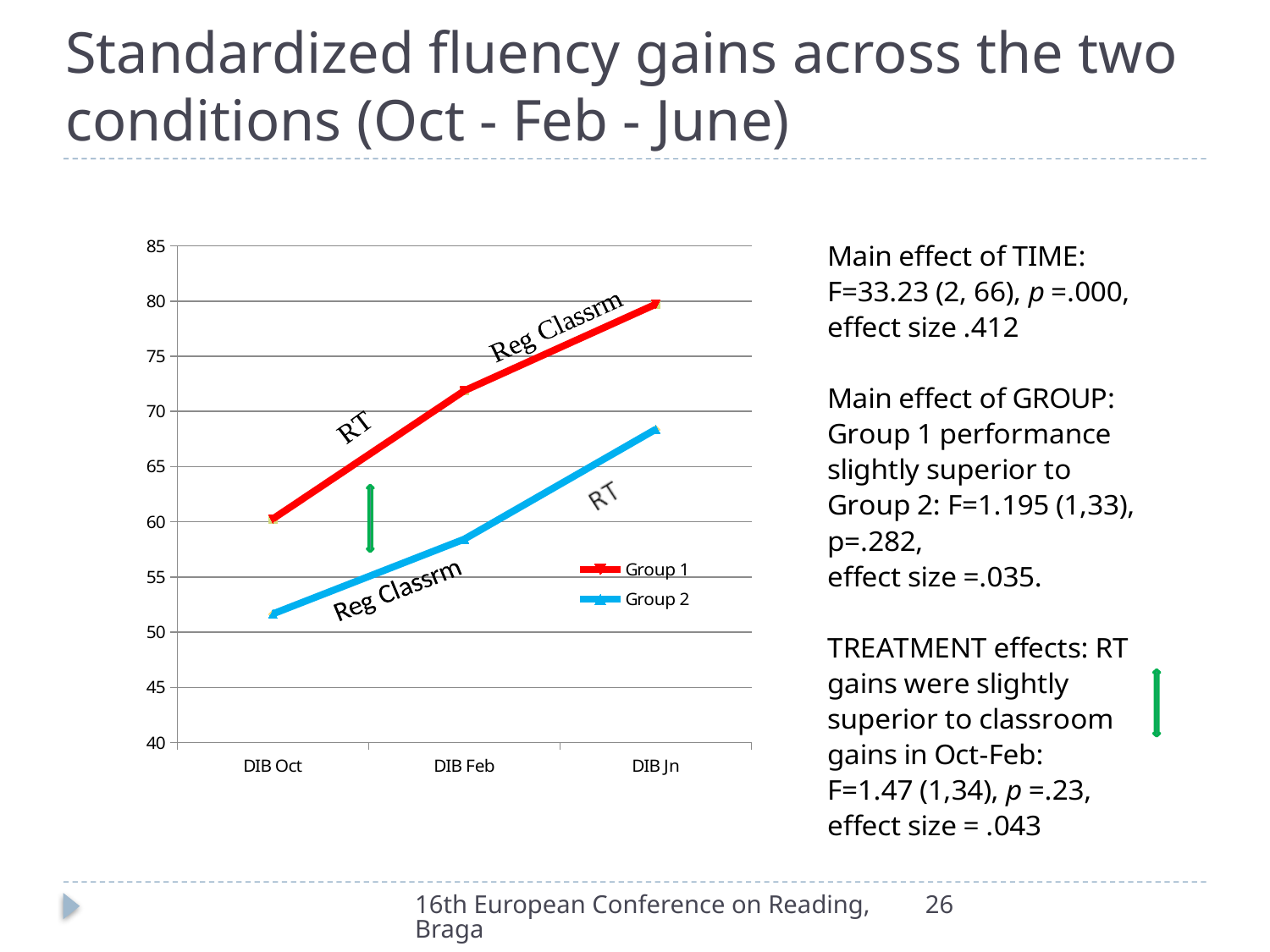
Is the value for Group 2 at DIB Oct greater or less than 55? less Do the values for Group 2 rise or fall from DIB Oct to DIB Jn? rise What kind of chart is shown on the slide? line chart What colour is the line for Group 1 in the chart? red At which time point is the value for Group 2 lowest? DIB Oct Do the values for Group 1 rise or fall from DIB Oct to DIB Jn? rise Is the value for Group 1 at DIB Jn greater or less than 75? greater Is the value for Group 1 at DIB Oct greater or less than 65? less Which series has the larger value at DIB Jn, Group 1 or Group 2? Group 1 How many time points are plotted along the x axis? 3 How many series does the chart's legend list? 2 At which time point is the value for Group 1 highest? DIB Jn